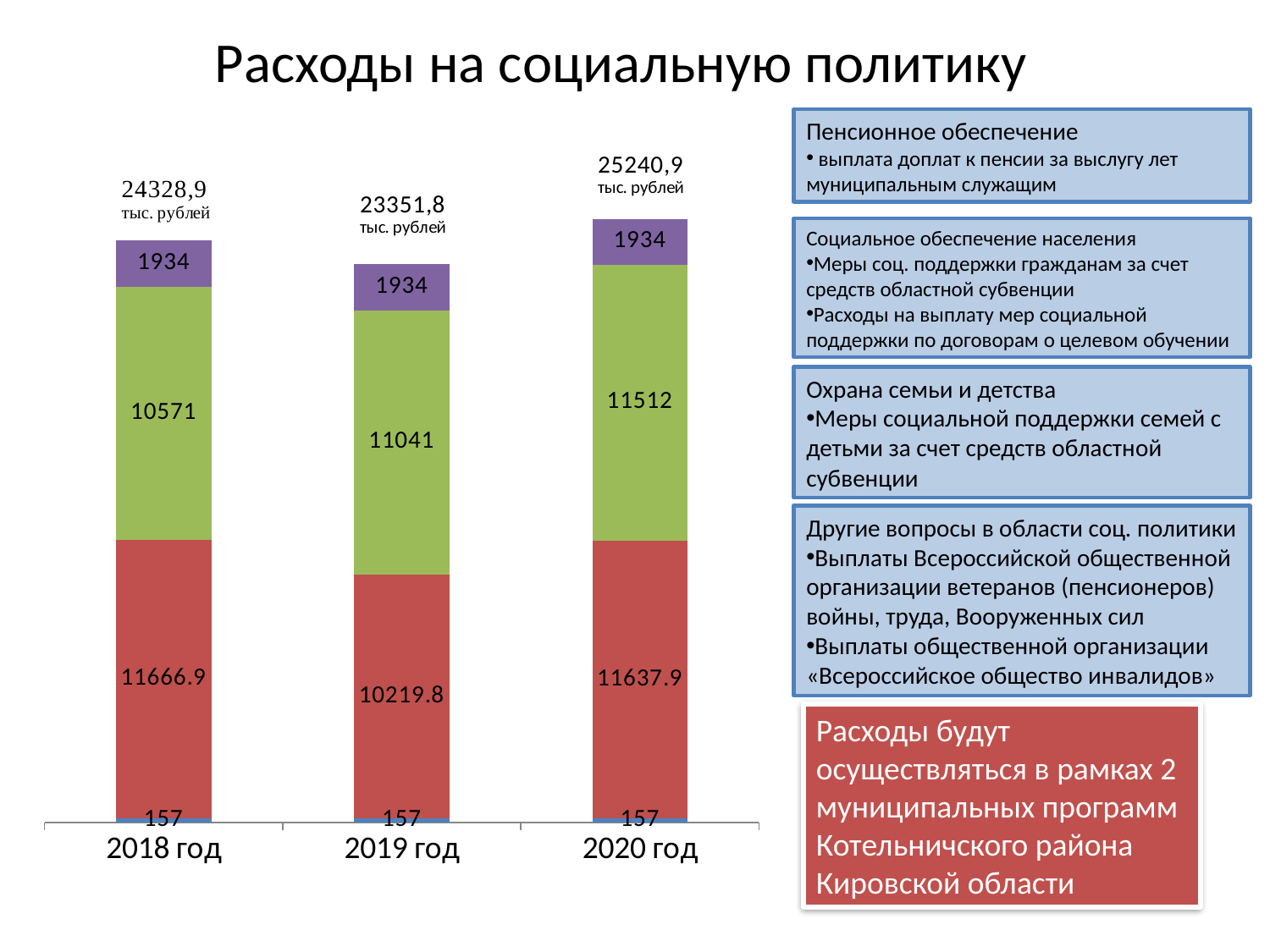
How many years (categories) are shown on the x axis of the chart? 3 What kind of chart is shown on the slide? Stacked bar chart Does the green segment rise or fall from 2018 год to 2020 год? Rises Which year has the highest total expenditure? 2020 год What is the value of the purple (top) segment in each bar? 1934 What is the value of the small blue segment at the bottom of each bar? 157 What is the value of the red segment in the bar for 2019 год? 10219.8 Which is larger: the red segment for 2018 год or the red segment for 2020 год? 2018 год (11666.9) What is the value of the green segment in the bar for 2020 год? 11512 What is the total value printed above the bar for 2018 год? 24328,9 тыс. рублей Which year has the lowest total expenditure? 2019 год By how much does the green segment for 2020 год exceed the green segment for 2019 год? 471